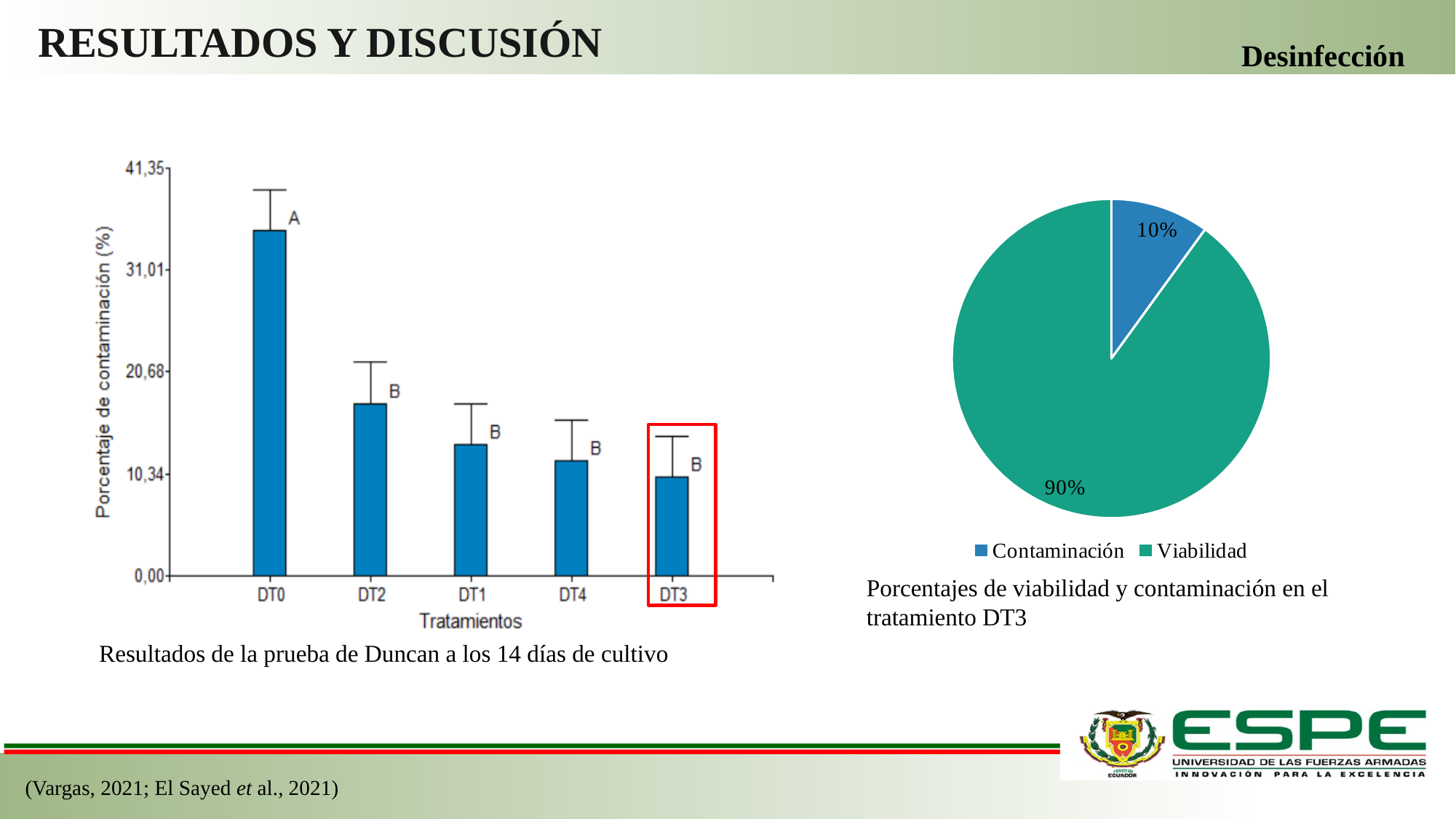
On the bar chart on the left, is the contamination percentage for DT1 greater or less than 10,34? greater On the bar chart on the left, which has a higher contamination percentage, DT0 or DT2? DT0 On the bar chart on the left, is the contamination percentage for DT0 greater or less than 31,01? greater On the bar chart on the left, which treatment has the highest percentage of contamination? DT0 What kind of chart is the chart on the left of the slide? bar chart On the bar chart on the left, do the contamination percentages rise or fall from DT0 to DT3 along the x axis? fall On the bar chart on the left, which treatment has the lowest percentage of contamination? DT3 On the bar chart on the left, is the contamination percentage for DT2 greater or less than 20,68? less How many treatments are shown on the bar chart on the left? 5 How many entries does the legend of the pie chart on the right list? 2 On the pie chart on the right, what percentage is Viabilidad? 90% On the pie chart on the right, what percentage is Contaminación? 10%